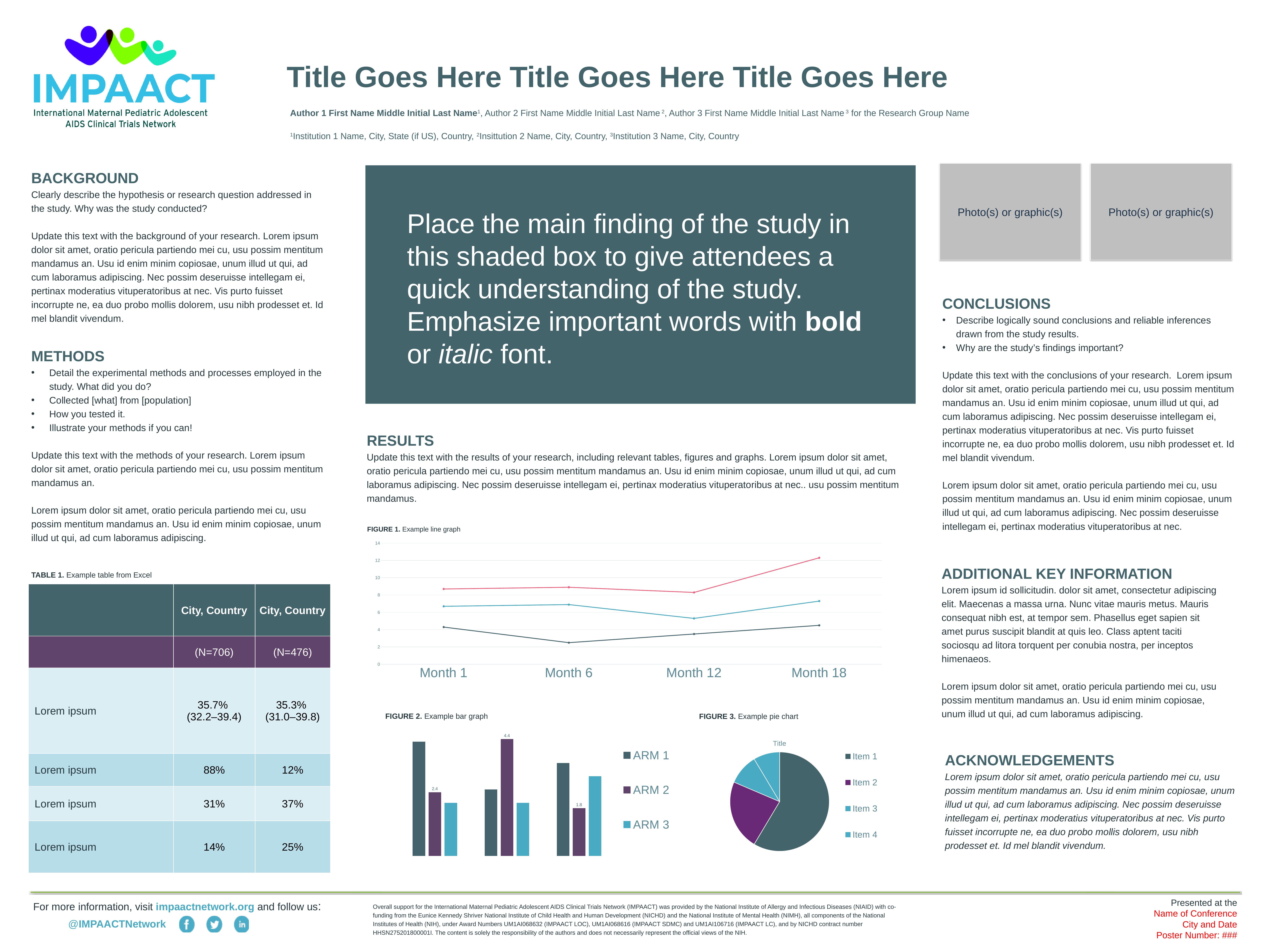
What kind of chart is Figure 1 (Example line graph)? line chart How many series does the legend of Figure 2 (Example bar graph) list? 3 In Figure 1 (Example line graph), how many time points are shown on the x axis? 4 In Figure 2 (Example bar graph), what is the highest labelled value for ARM 2? 4.4 What kind of chart is Figure 3 (Example pie chart)? pie chart In Figure 2 (Example bar graph), what is the difference between the highest and lowest labelled ARM 2 values (4.4 and 1.8)? 2.6 In Figure 3 (Example pie chart), which item has the largest slice? Item 1 In Figure 1 (Example line graph), does the red line rise or fall between Month 12 and Month 18? rises In Figure 1 (Example line graph), is the value of the red line at Month 18 greater or less than 10? greater What kind of chart is Figure 2 (Example bar graph)? bar chart In Figure 1 (Example line graph), at which month does the red line reach its highest value? Month 18 In Figure 1 (Example line graph), is the value of the dark line at Month 6 greater or less than 4? less